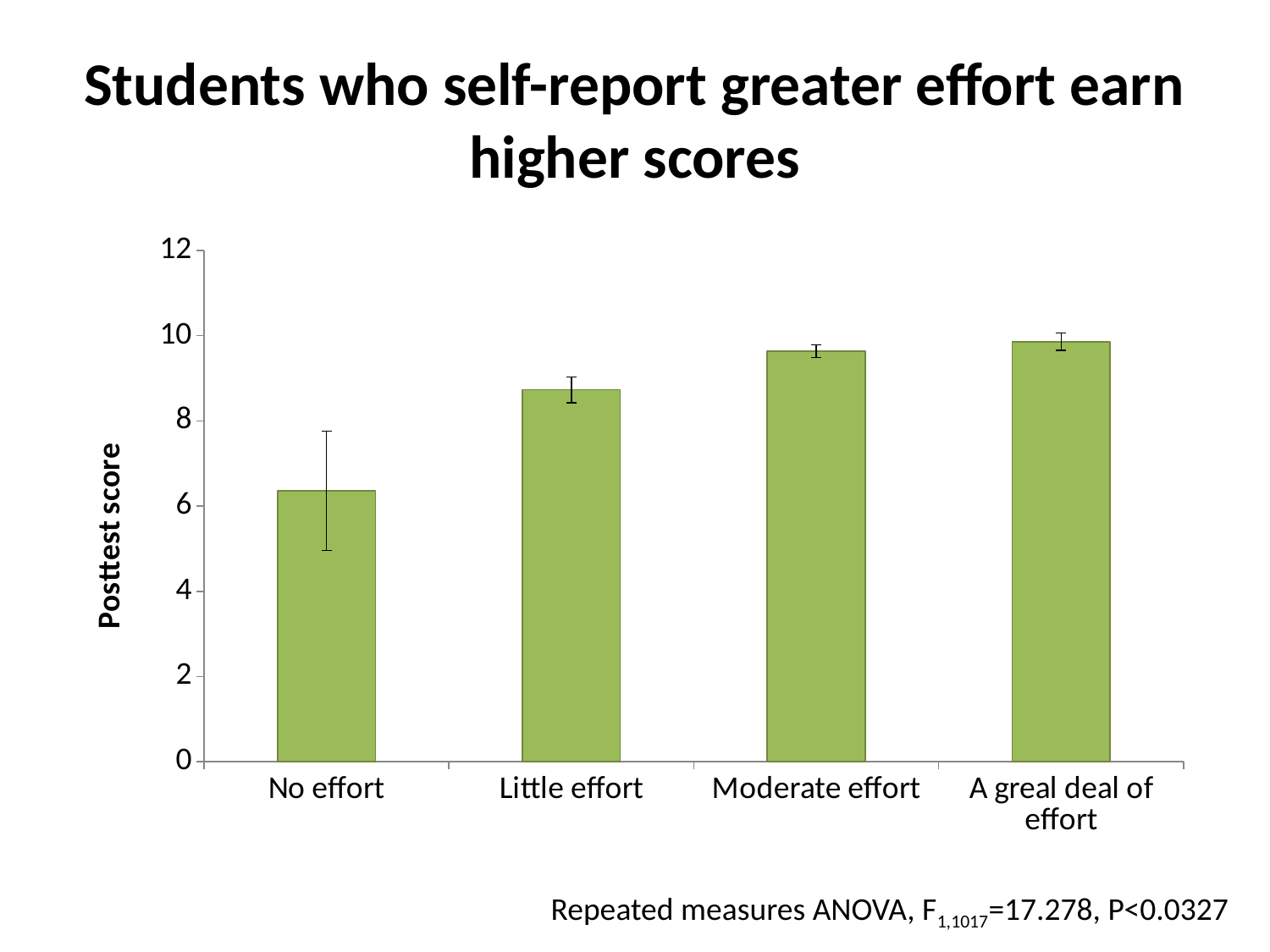
Is the posttest score for Moderate effort greater or less than 8? greater Is the posttest score for Moderate effort greater or less than 10? less Is the posttest score for No effort greater or less than 4? greater What kind of chart is shown on the slide? Bar chart What is the label of the y axis? Posttest score Do the posttest scores rise or fall as effort increases from No effort to A greal deal of effort? rise Which has a higher posttest score, No effort or Little effort? Little effort Which has a higher posttest score, Little effort or Moderate effort? Moderate effort Which effort category has the lowest posttest score? No effort How many effort categories are shown on the x axis? 4